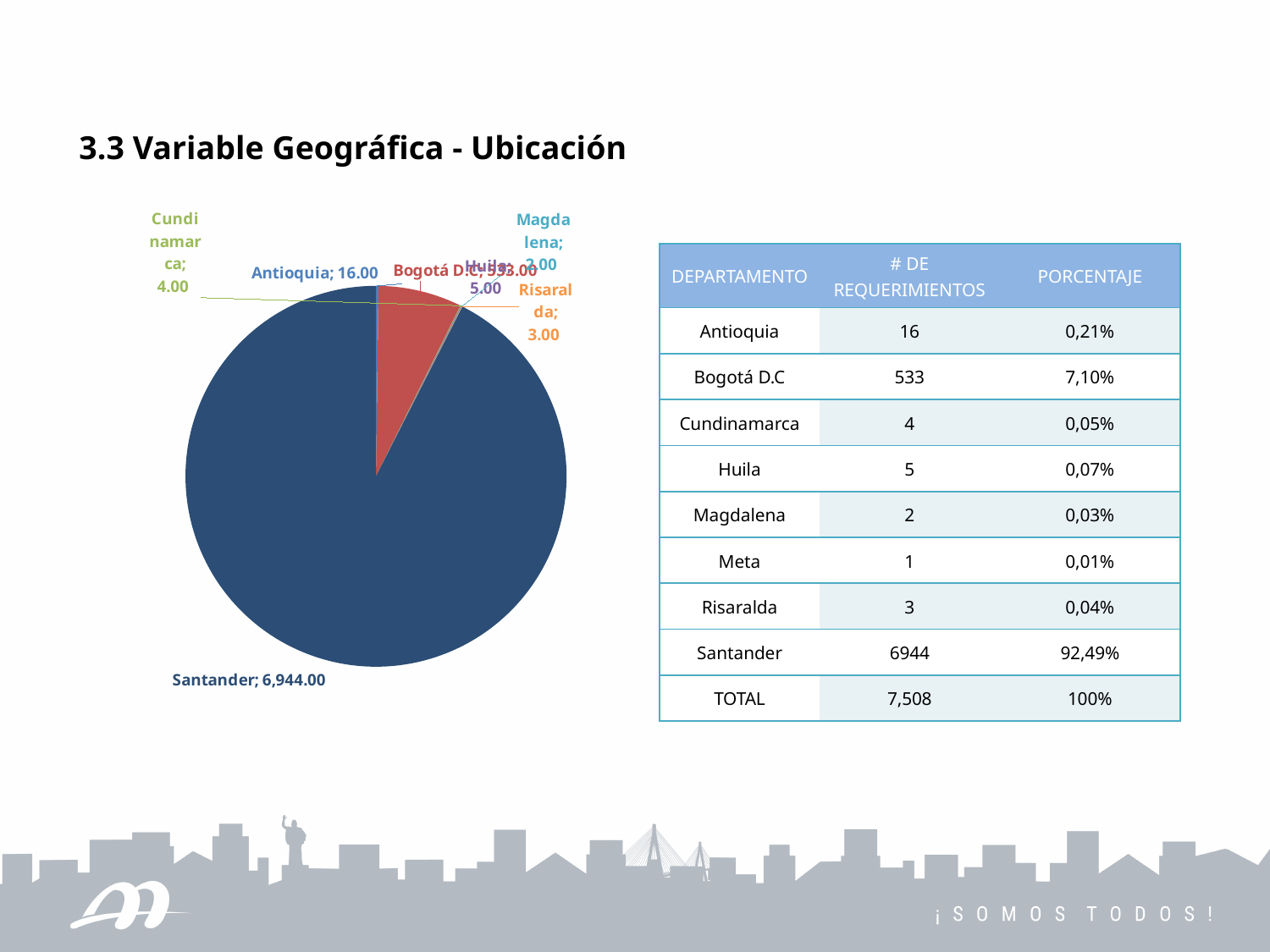
What value is labelled for Cundinamarca on the pie chart? 4.00 What kind of chart is shown on the slide? pie chart On the pie chart, which has the larger labelled value, Bogotá D.C or Antioquia? Bogotá D.C What value is labelled for Santander on the pie chart? 6,944.00 What is the difference between the labelled values for Santander and Bogotá D.C on the pie chart? 6,411.00 Which department has the largest slice of the pie chart? Santander On the pie chart, which has the larger labelled value, Huila or Cundinamarca? Huila What colour is the Santander slice of the pie chart? dark blue What value is labelled for Bogotá D.C on the pie chart? 533.00 What is the difference between the labelled values for Bogotá D.C and Antioquia on the pie chart? 517.00 What value is labelled for Risaralda on the pie chart? 3.00 What value is labelled for Antioquia on the pie chart? 16.00